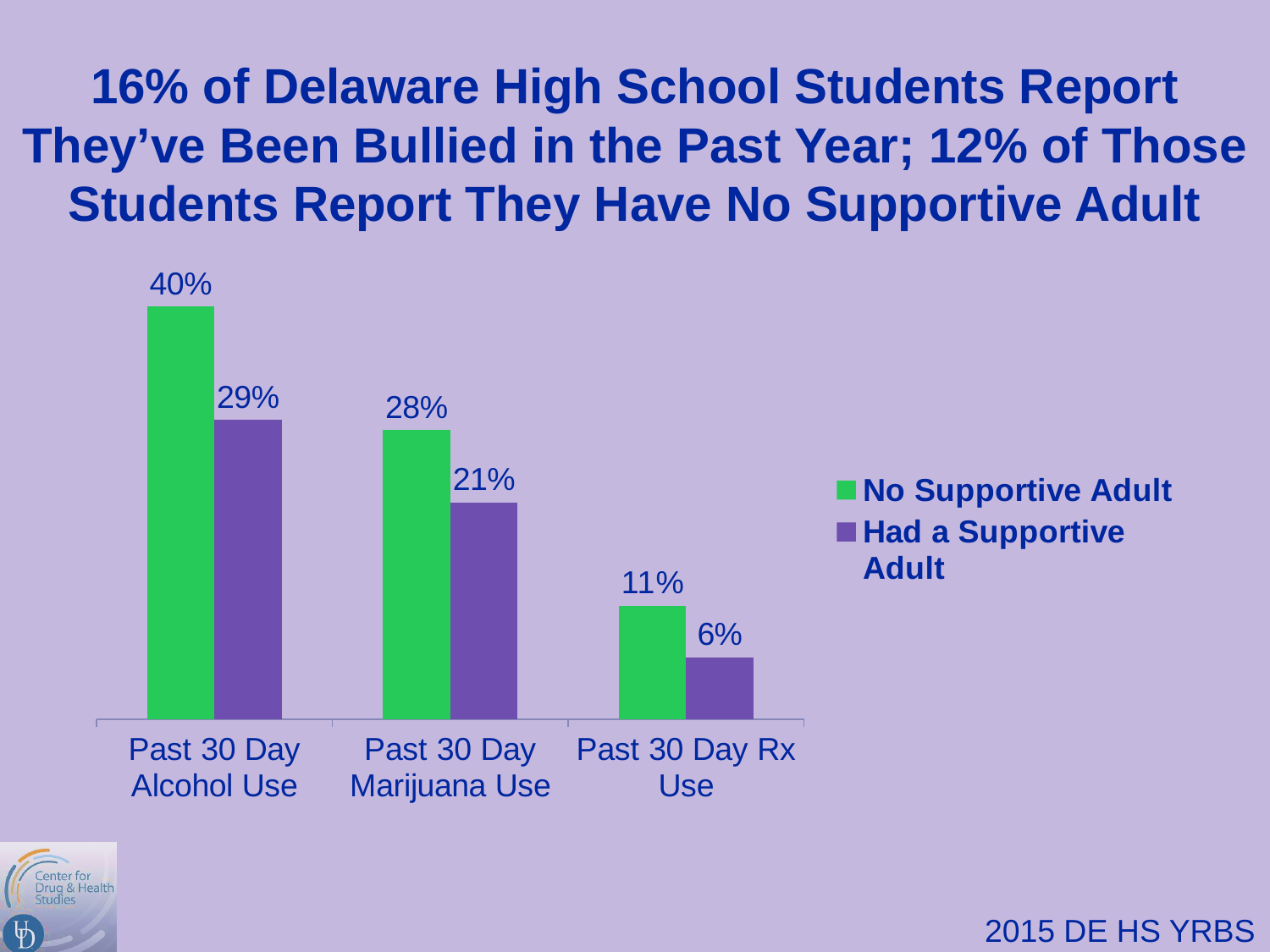
What is the value for Had a Supportive Adult for Past 30 Day Marijuana Use? 21% Which category has the highest value for No Supportive Adult? Past 30 Day Alcohol Use How many series does the legend list? 2 What is the difference between No Supportive Adult and Had a Supportive Adult for Past 30 Day Alcohol Use? 11% What is the value for Had a Supportive Adult for Past 30 Day Rx Use? 6% What is the value for No Supportive Adult for Past 30 Day Rx Use? 11% What is the difference between No Supportive Adult and Had a Supportive Adult for Past 30 Day Marijuana Use? 7% What kind of chart is shown on the slide? Bar chart What is the value for No Supportive Adult for Past 30 Day Alcohol Use? 40% Which category has the lowest value for Had a Supportive Adult? Past 30 Day Rx Use Which is larger for Past 30 Day Rx Use: No Supportive Adult or Had a Supportive Adult? No Supportive Adult How many categories are shown on the x axis? 3